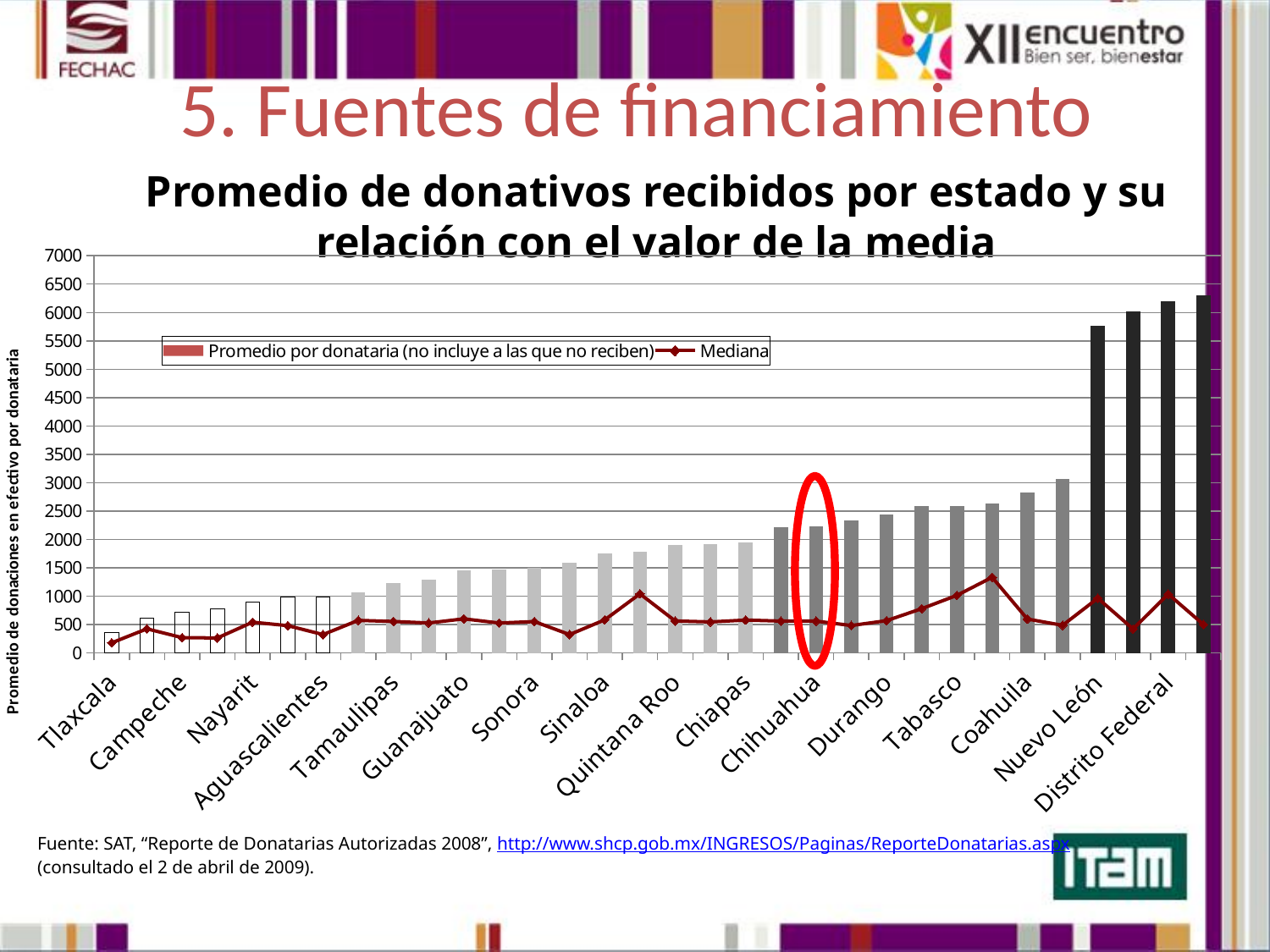
Which state is circled in red on the chart? Chihuahua Is the bar for Tlaxcala greater or less than 500? less Is the bar for Distrito Federal greater or less than 6000? greater Which bar is taller, Coahuila or Durango? Coahuila What kind of chart is shown on the slide? combination bar and line chart Do the bar values rise or fall from left to right along the x axis? rise How many series does the legend list? 2 Is the bar for Tamaulipas greater or less than 1500? less Which state has the lowest average donation bar? Tlaxcala